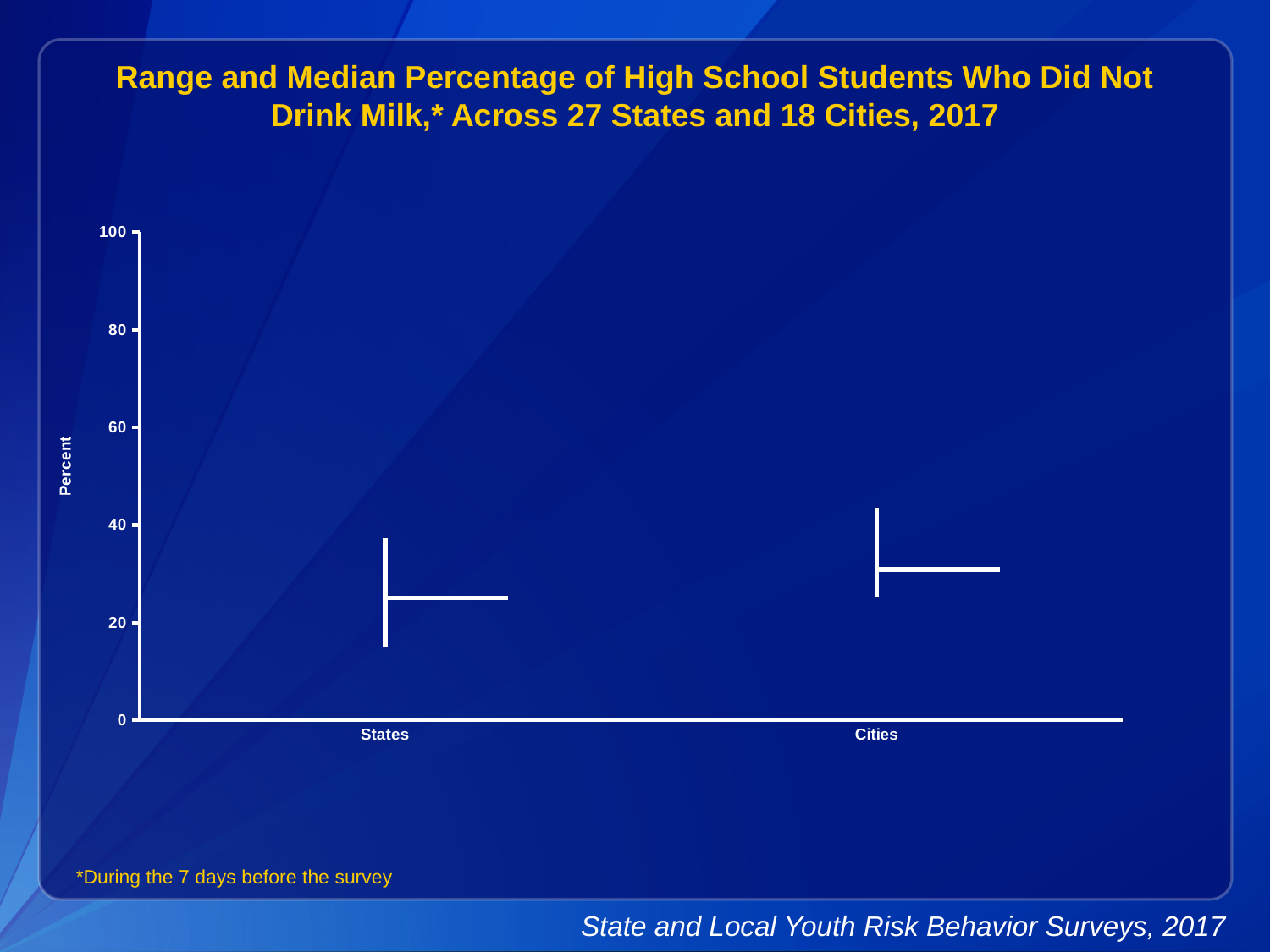
According to the chart title, how many states and how many cities are included? 27 states and 18 cities What is the label on the y axis of the chart? Percent Is the lowest value in the range for States greater or less than 20? less Which category has the higher median percentage, States or Cities? Cities Is the highest value in the range for States greater or less than 60? less Is the median value for Cities greater or less than 40? less Which category has the lower minimum value in its range, States or Cities? States How many categories are shown on the x axis of the chart? 2 Which category has the higher maximum value in its range, States or Cities? Cities